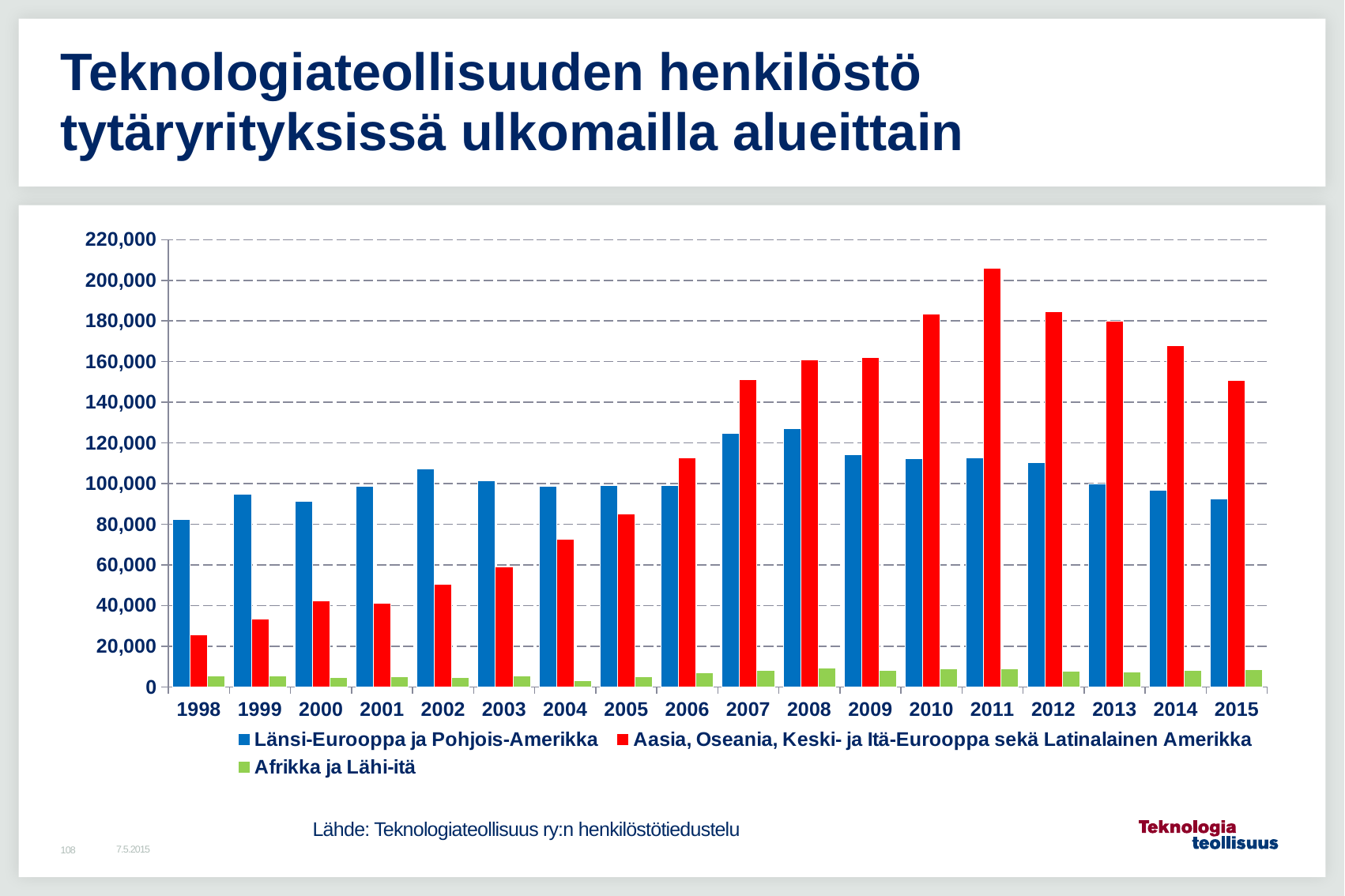
Is the value for Länsi-Eurooppa ja Pohjois-Amerikka in 2008 greater or less than 120,000? greater In which year is the value for Länsi-Eurooppa ja Pohjois-Amerikka lowest? 1998 In which year is the value for Aasia, Oseania, Keski- ja Itä-Eurooppa sekä Latinalainen Amerikka lowest? 1998 Does the value for Aasia, Oseania, Keski- ja Itä-Eurooppa sekä Latinalainen Amerikka rise or fall from 1998 to 2011? Rise In 2015, which series has the larger value: Länsi-Eurooppa ja Pohjois-Amerikka or Aasia, Oseania, Keski- ja Itä-Eurooppa sekä Latinalainen Amerikka? Aasia, Oseania, Keski- ja Itä-Eurooppa sekä Latinalainen Amerikka How many series does the legend list? 3 In which year is the value for Aasia, Oseania, Keski- ja Itä-Eurooppa sekä Latinalainen Amerikka highest? 2011 Is the value for Aasia, Oseania, Keski- ja Itä-Eurooppa sekä Latinalainen Amerikka in 1998 greater or less than 40,000? less How many years are shown on the x axis? 18 In 1998, which series has the larger value: Länsi-Eurooppa ja Pohjois-Amerikka or Aasia, Oseania, Keski- ja Itä-Eurooppa sekä Latinalainen Amerikka? Länsi-Eurooppa ja Pohjois-Amerikka What kind of chart is shown on the slide? Bar chart Is the value for Aasia, Oseania, Keski- ja Itä-Eurooppa sekä Latinalainen Amerikka in 2011 greater or less than 200,000? greater